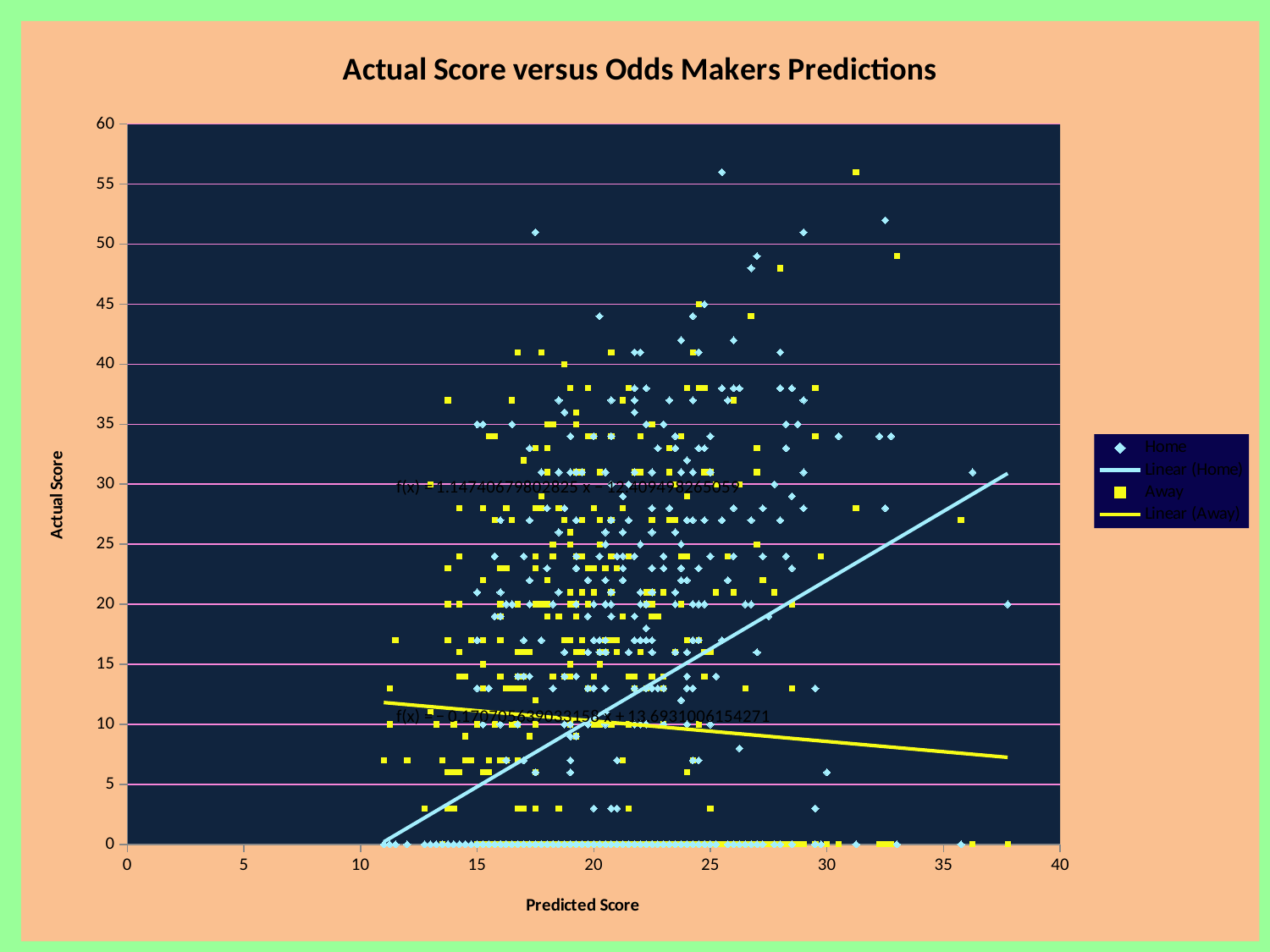
How many entries does the chart's legend list? 4 What kind of chart is shown on the slide? Scatter chart Which trendline has the steeper slope, Linear (Home) or Linear (Away)? Linear (Home) What is the highest value shown on the horizontal axis? 40 What is the title of the chart? Actual Score versus Odds Makers Predictions What is the label of the horizontal axis? Predicted Score What is the highest value shown on the vertical axis? 60 Which series is plotted with yellow square markers? Away Does the Linear (Home) trendline rise or fall as Predicted Score increases? Rises Does the Linear (Away) trendline rise or fall as Predicted Score increases? Falls